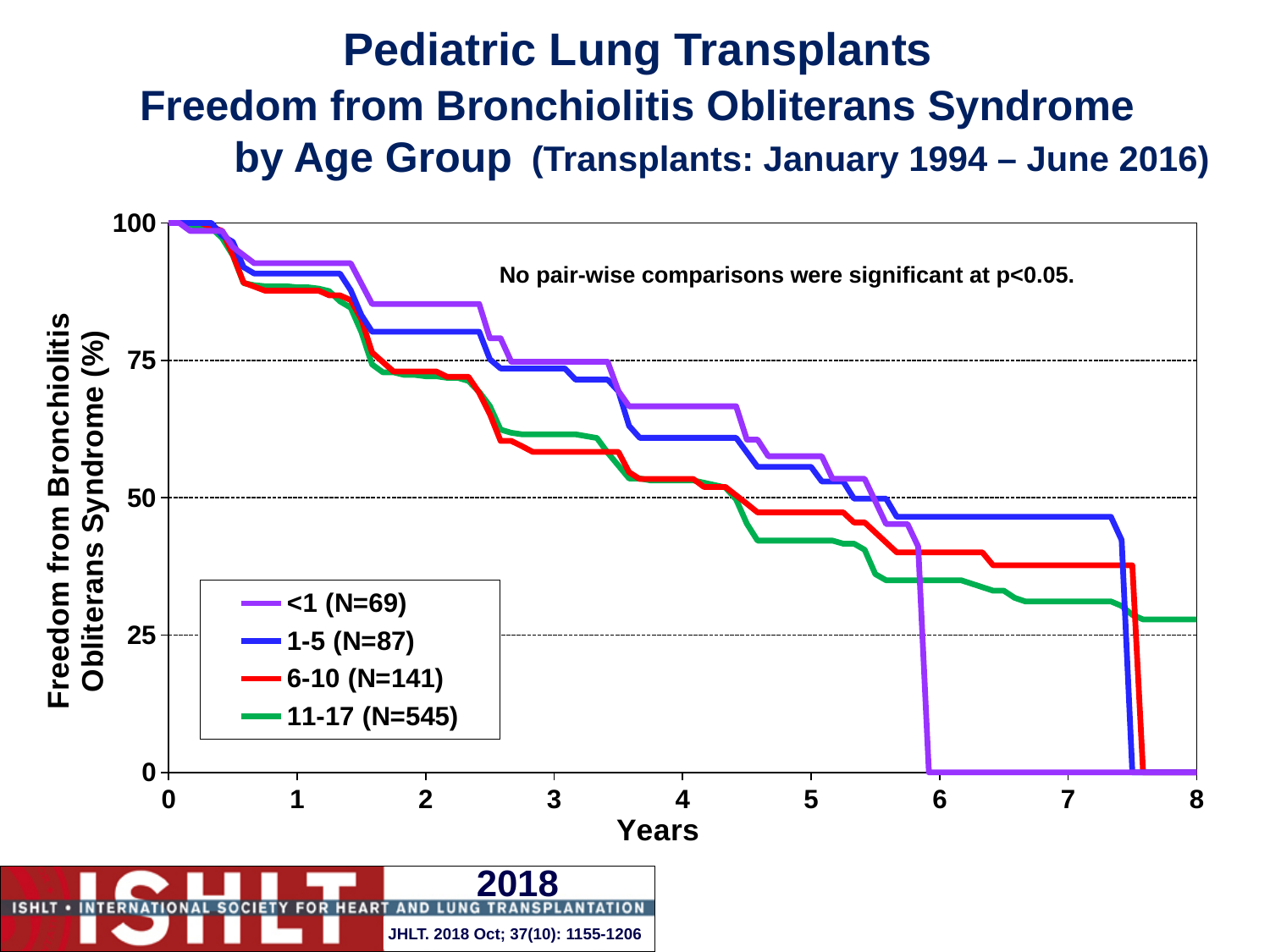
At year 2, is the value for the <1 age group greater or less than 75? greater At year 7, is the value for the 11-17 age group greater or less than 25? greater Do the freedom from bronchiolitis obliterans syndrome curves rise or fall as years increase? fall What is the label of the x axis? Years What is the sample size (N) for the <1 age group? 69 At year 7, which has the higher freedom from bronchiolitis obliterans syndrome, the 1-5 group or the 11-17 group? 1-5 What is the sample size (N) for the 11-17 age group? 545 What kind of chart is shown on the slide? line chart At year 2, which has the higher freedom from bronchiolitis obliterans syndrome, the <1 group or the 11-17 group? <1 At year 5, is the value for the 6-10 age group greater or less than 50? less What is the freedom from bronchiolitis obliterans syndrome for all age groups at year 0? 100 How many age groups does the legend list? 4